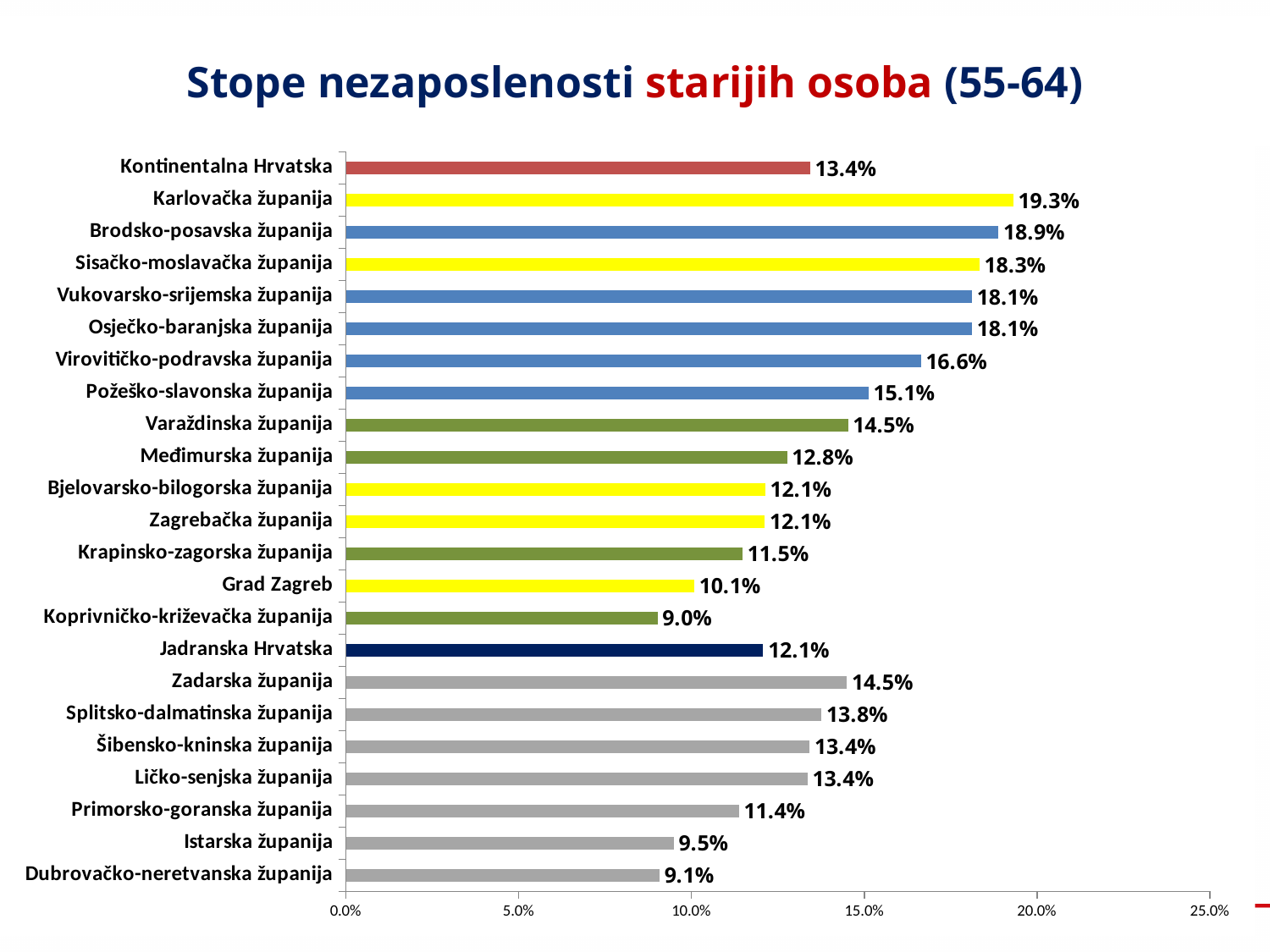
What is the difference between the values for Karlovačka županija and Dubrovačko-neretvanska županija? 10.2% What is the value shown for Istarska županija? 9.5% Which category has the highest value on the chart? Karlovačka županija What is the value shown for Jadranska Hrvatska? 12.1% What is the value shown for Kontinentalna Hrvatska? 13.4% How many categories are plotted on the chart? 23 Which has a higher value, Zadarska županija or Splitsko-dalmatinska županija? Zadarska županija What is the difference between the values for Kontinentalna Hrvatska and Jadranska Hrvatska? 1.3% What is the unemployment rate shown for Karlovačka županija? 19.3% What kind of chart is shown on the slide? Bar chart What is the title of the chart on the slide? Stope nezaposlenosti starijih osoba (55-64) Which category has the lowest value on the chart? Koprivničko-križevačka županija